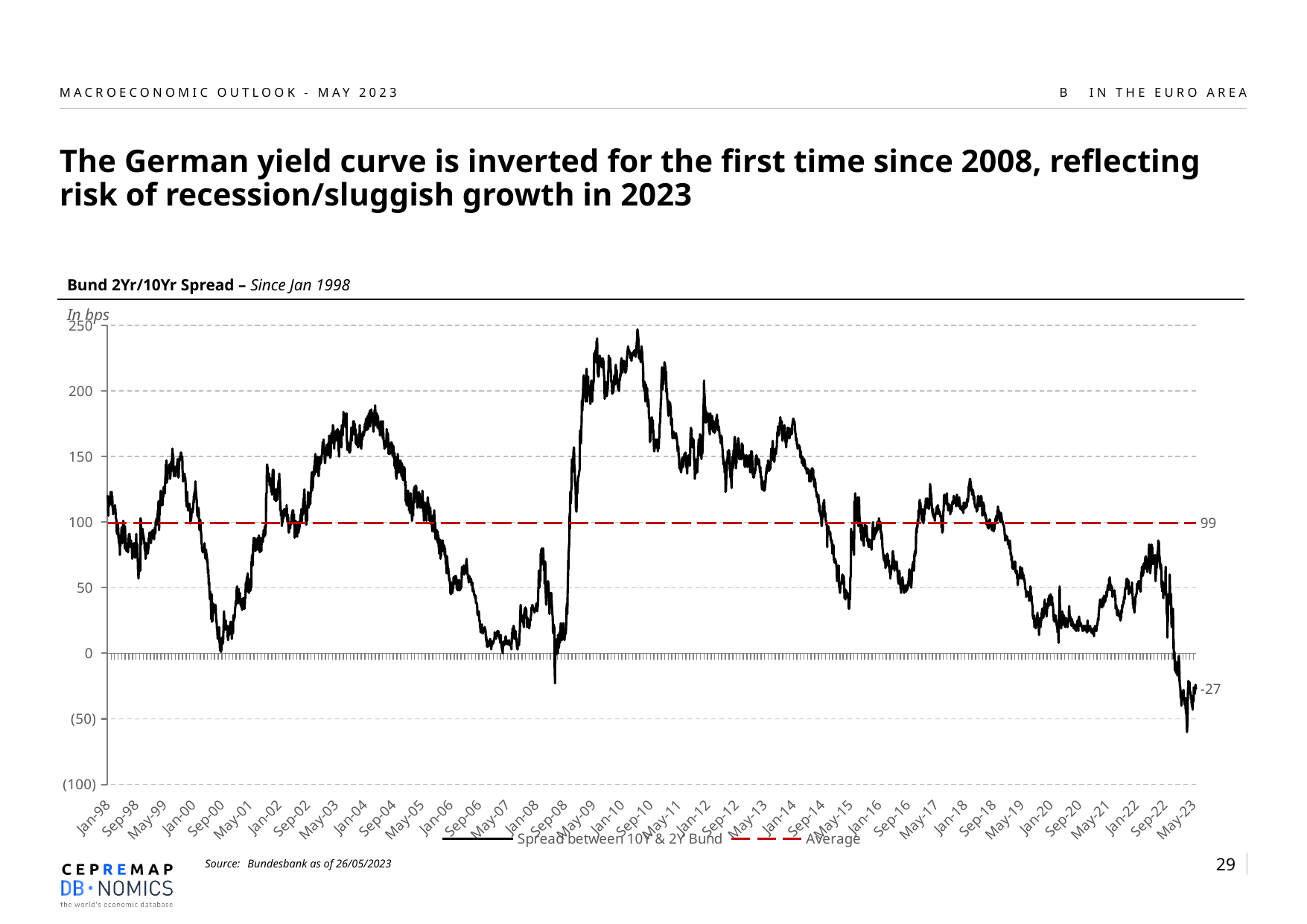
What is the latest value of the spread between 10Y & 2Y Bund labelled at the right end of the chart? -27 What is the value of the Average line shown on the chart? 99 What is the title of the chart? Bund 2Yr/10Yr Spread – Since Jan 1998 In what unit are the values on the chart expressed? bps Does the spread rise or fall between Jan-22 and May-23? fall Is the latest value of the spread greater or less than 0? less What kind of chart is shown on the slide? line chart Is the Average value greater or less than 100? less Is the peak value of the spread around 2010 greater or less than 200? greater How many series does the legend list? 2 Which is larger, the Average value or the latest spread value? Average What is the difference between the Average (99) and the latest spread value (-27)? 126